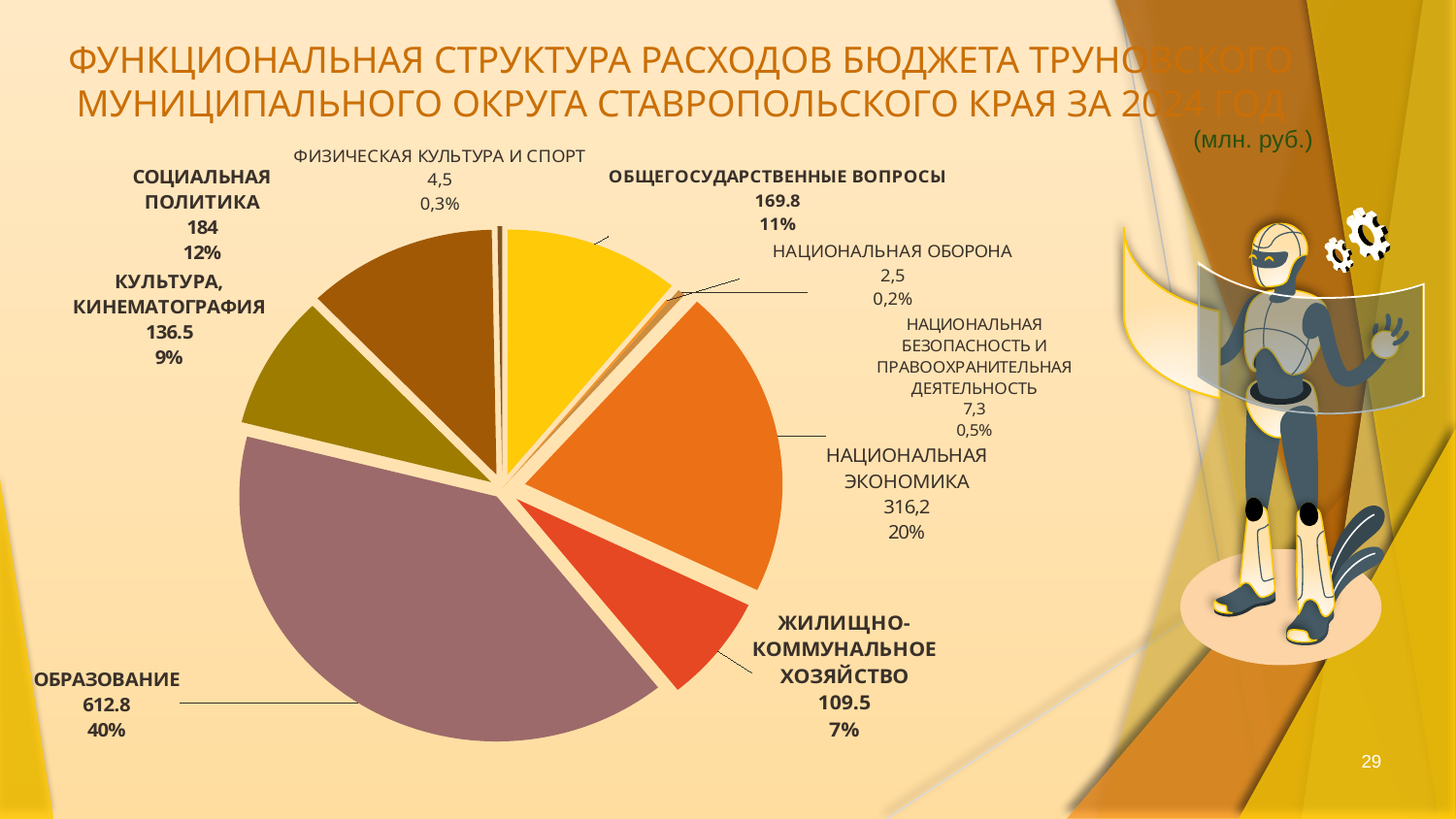
How many categories (slices) does the pie chart show? 9 Which is larger, the value for НАЦИОНАЛЬНАЯ ЭКОНОМИКА or the value for ОБЩЕГОСУДАРСТВЕННЫЕ ВОПРОСЫ? НАЦИОНАЛЬНАЯ ЭКОНОМИКА What share of the pie does ОБЩЕГОСУДАРСТВЕННЫЕ ВОПРОСЫ represent? 11% What is the value for НАЦИОНАЛЬНАЯ ЭКОНОМИКА? 316,2 Which category has the smallest value? НАЦИОНАЛЬНАЯ ОБОРОНА What is the value for ОБРАЗОВАНИЕ? 612.8 What is the difference between the values for СОЦИАЛЬНАЯ ПОЛИТИКА and КУЛЬТУРА, КИНЕМАТОГРАФИЯ? 47.5 What is the value for ЖИЛИЩНО-КОММУНАЛЬНОЕ ХОЗЯЙСТВО? 109.5 In what units are the values on the chart given? млн. руб. What kind of chart is shown on the slide? pie chart What share of the pie does СОЦИАЛЬНАЯ ПОЛИТИКА represent? 12% Which category has the largest value? ОБРАЗОВАНИЕ